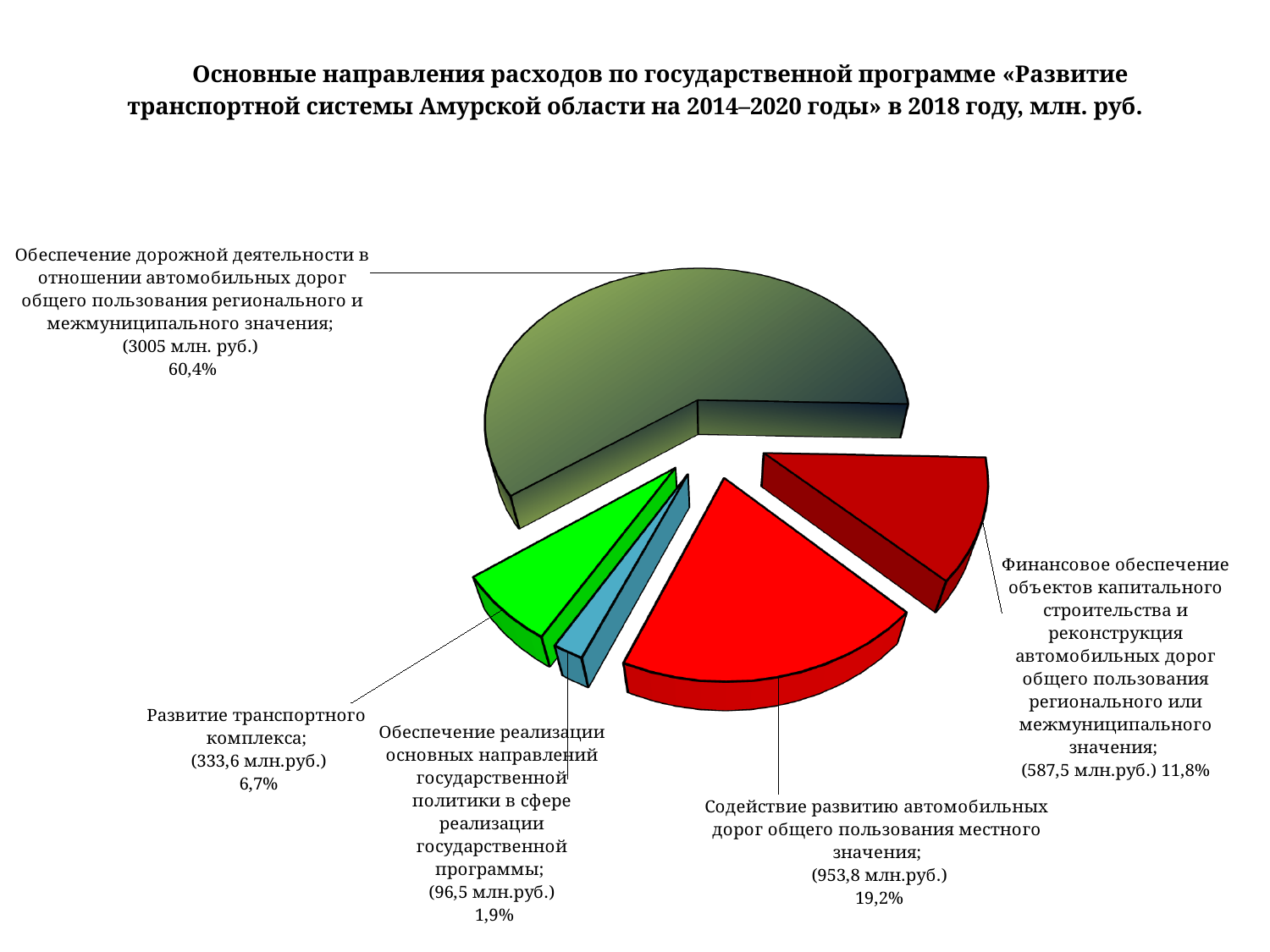
What is the value for «Содействие развитию автомобильных дорог общего пользования местного значения»? 953,8 млн.руб. What is the value for «Развитие транспортного комплекса»? 333,6 млн.руб. What share of the pie does «Финансовое обеспечение объектов капитального строительства и реконструкция автомобильных дорог общего пользования регионального или межмуниципального значения» represent? 11,8% What type of chart is shown on the slide? pie chart Which category has the smallest slice of the pie? Обеспечение реализации основных направлений государственной политики в сфере реализации государственной программы What is the difference in млн. руб. between «Содействие развитию автомобильных дорог общего пользования местного значения» and «Финансовое обеспечение объектов капитального строительства и реконструкция автомобильных дорог общего пользования регионального или межмуниципального значения»? 366,3 млн.руб. Which is larger: «Развитие транспортного комплекса» or «Финансовое обеспечение объектов капитального строительства и реконструкция автомобильных дорог общего пользования регионального или межмуниципального значения»? Финансовое обеспечение объектов капитального строительства и реконструкция автомобильных дорог общего пользования регионального или межмуниципального значения How many slices does the pie chart have? 5 Which category has the largest slice of the pie? Обеспечение дорожной деятельности в отношении автомобильных дорог общего пользования регионального и межмуниципального значения What colour is the slice for «Развитие транспортного комплекса»? green What share of the pie does «Обеспечение дорожной деятельности в отношении автомобильных дорог общего пользования регионального и межмуниципального значения» represent? 60,4% What is the value for «Обеспечение реализации основных направлений государственной политики в сфере реализации государственной программы»? 96,5 млн.руб.